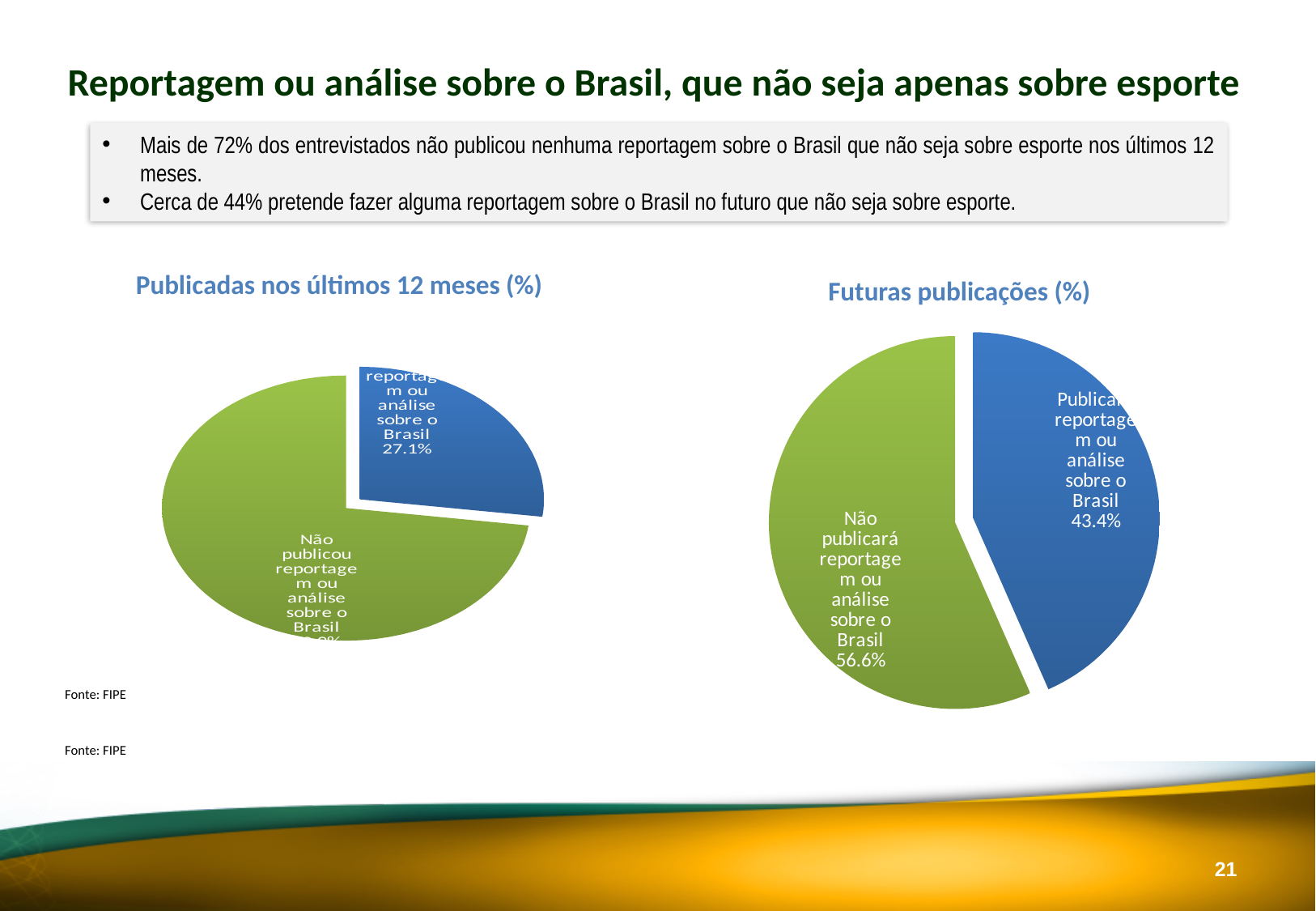
In the 'Futuras publicações (%)' chart, which slice is the smallest? Publicará reportagem ou análise sobre o Brasil What kind of chart is the 'Publicadas nos últimos 12 meses (%)' chart? pie chart In the 'Futuras publicações (%)' chart, which slice is the largest? Não publicará reportagem ou análise sobre o Brasil In the 'Futuras publicações (%)' chart, what percentage is shown for 'Publicará reportagem ou análise sobre o Brasil'? 43.4% How many slices does the 'Publicadas nos últimos 12 meses (%)' pie chart have? 2 In the 'Publicadas nos últimos 12 meses (%)' chart, what percentage is shown for the blue slice? 27.1% In the 'Publicadas nos últimos 12 meses (%)' chart, which slice is larger: the green 'Não publicou' slice or the blue slice? Não publicou reportagem ou análise sobre o Brasil What kind of chart is the 'Futuras publicações (%)' chart? pie chart In the 'Futuras publicações (%)' chart, what percentage is shown for 'Não publicará reportagem ou análise sobre o Brasil'? 56.6% How many slices does the 'Futuras publicações (%)' pie chart have? 2 In the 'Futuras publicações (%)' chart, what is the difference in percentage points between 'Não publicará' and 'Publicará'? 13.2 In the 'Futuras publicações (%)' chart, what colour is the 'Não publicará' slice? green